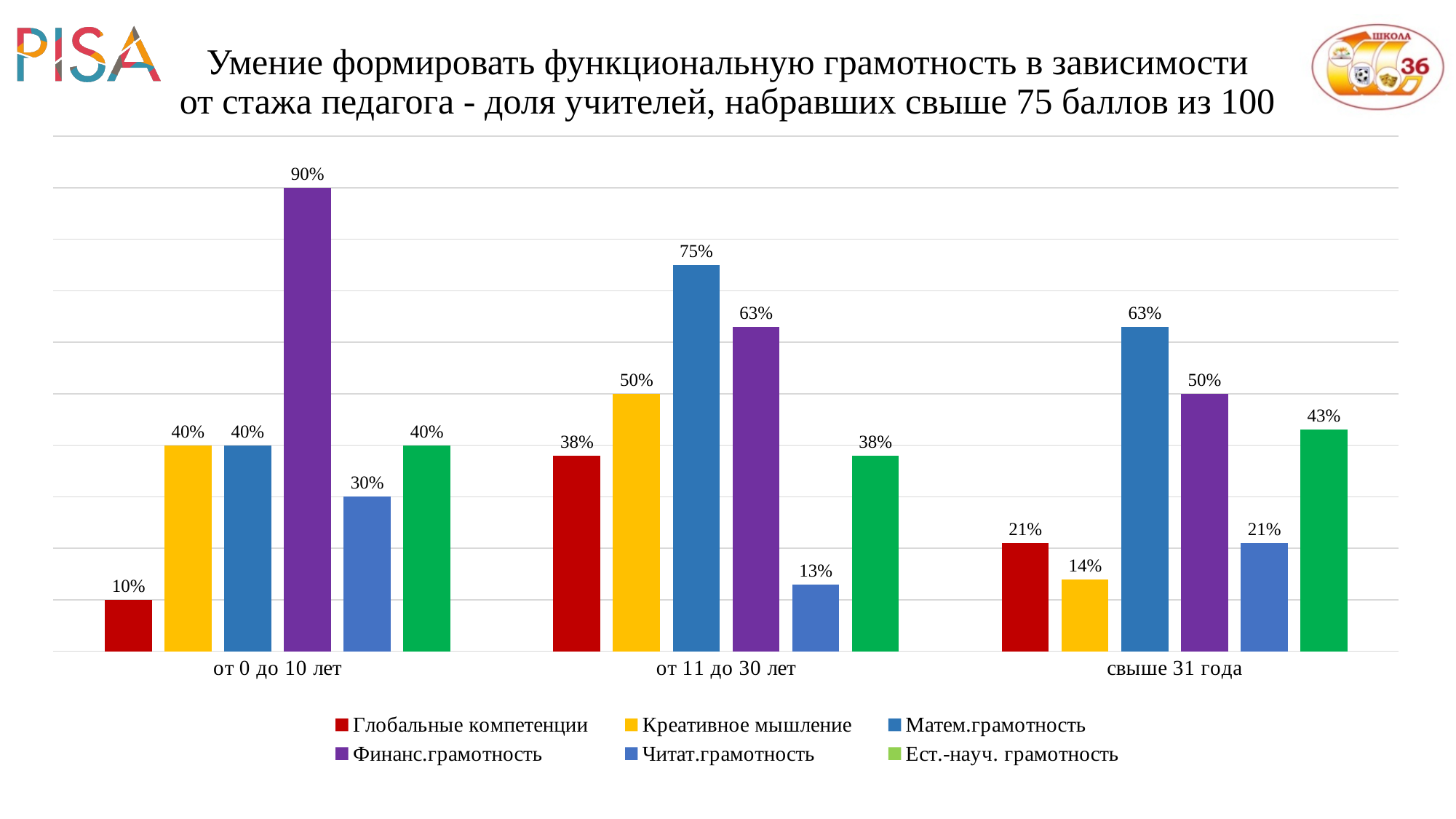
What is the value for Креативное мышление in the category свыше 31 года? 14% Which is larger: Ест.-науч. грамотность in свыше 31 года or Ест.-науч. грамотность in от 11 до 30 лет? свыше 31 года Which series has the highest value in the category от 0 до 10 лет? Финанс.грамотность Does the value for Глобальные компетенции rise or fall from от 0 до 10 лет to от 11 до 30 лет? Rise What is the value for Матем.грамотность in the category от 11 до 30 лет? 75% What kind of chart is shown on the slide? Bar chart How many series does the legend list? 6 How many categories are shown on the x axis? 3 What is the value for Читат.грамотность in the category свыше 31 года? 21% Which series has the lowest value in the category от 11 до 30 лет? Читат.грамотность What is the difference between Матем.грамотность and Глобальные компетенции in the category от 11 до 30 лет? 37% What is the value for Финанс.грамотность in the category от 0 до 10 лет? 90%